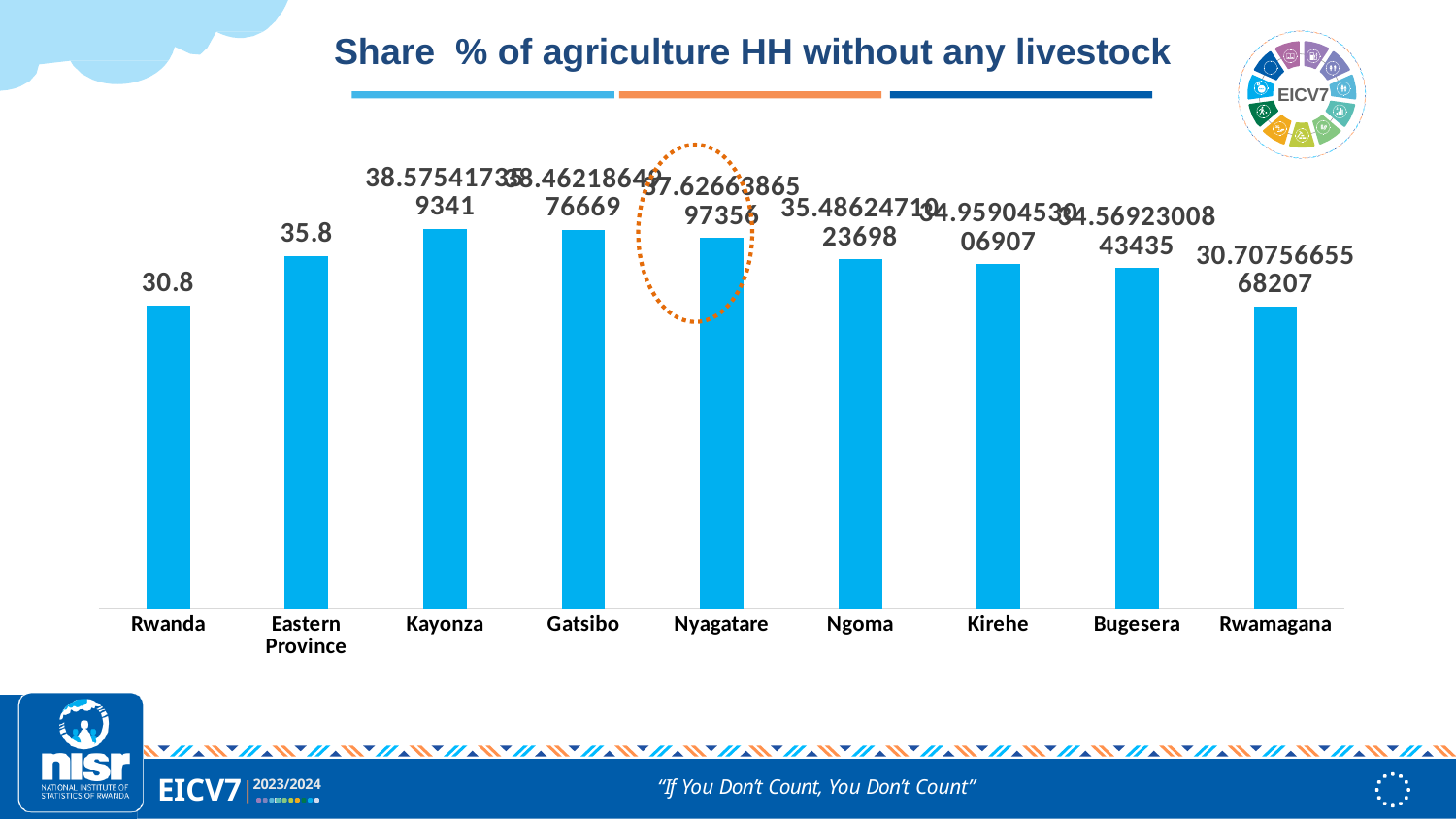
What is the title of the chart? Share % of agriculture HH without any livestock What is the value shown for Eastern Province? 35.8 What is the value shown for Rwanda? 30.8 Which category's bar is highlighted with a dotted orange circle? Nyagatare What kind of chart is shown on the slide? bar chart Which is larger, the value for Eastern Province or the value for Rwanda? Eastern Province Which is larger, the value for Bugesera or the value for Rwamagana? Bugesera Which is larger, the value for Kayonza or the value for Rwamagana? Kayonza How many categories are shown on the x axis of the chart? 9 What is the difference between the values for Eastern Province and Rwanda? 5